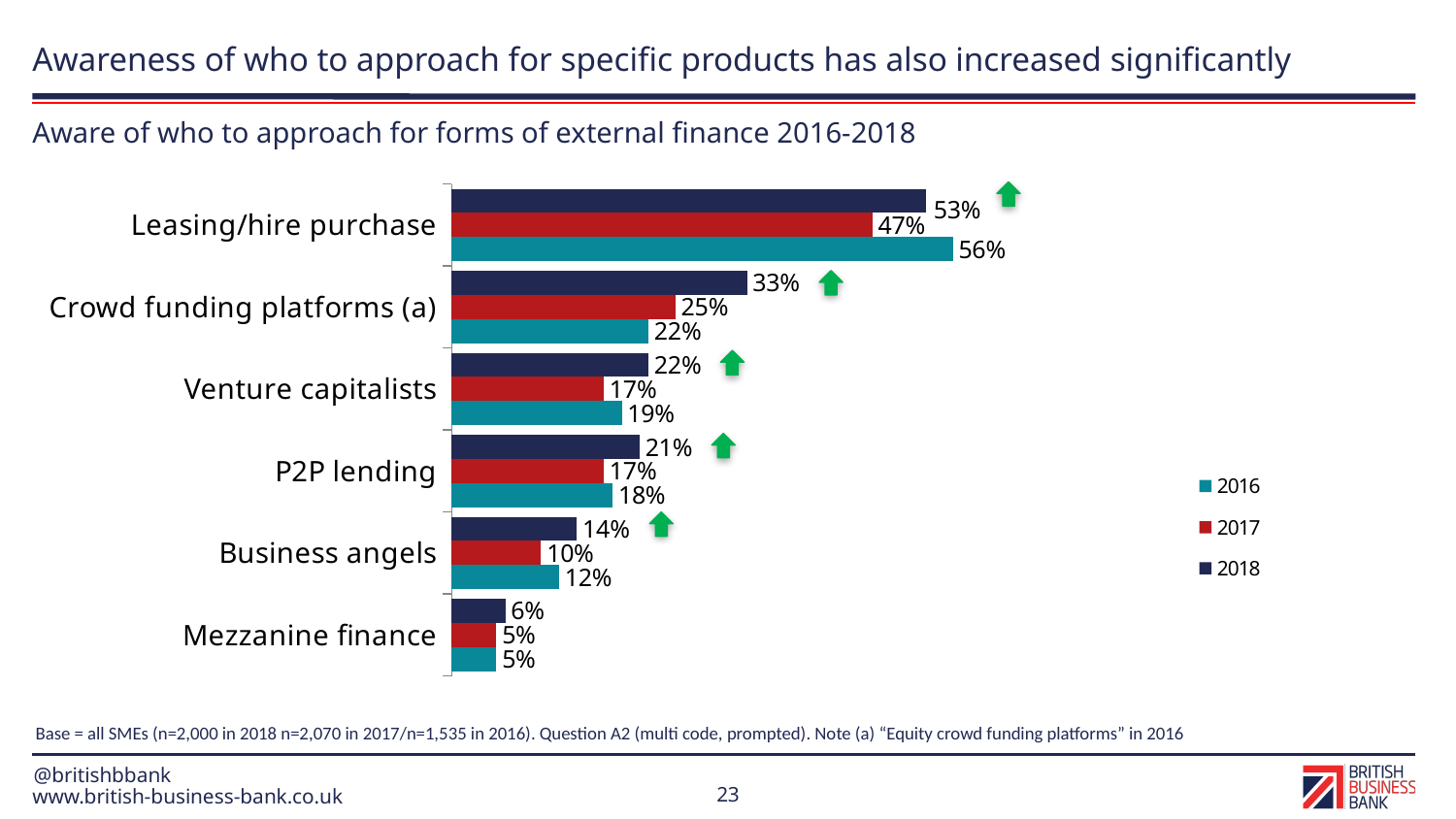
What is the difference between the 2016 and 2018 values for Leasing/hire purchase? 3% What is the 2018 value for Leasing/hire purchase? 53% What type of chart is shown on the slide? Bar chart What is the 2017 value for Business angels? 10% How many categories are shown on the chart? 6 What is the 2016 value for Crowd funding platforms (a)? 22% Which is larger for Venture capitalists: the 2016 value or the 2017 value? 2016 What is the difference between the 2018 and 2017 values for Crowd funding platforms (a)? 8% How many series does the legend list? 3 Which category has the highest 2018 value? Leasing/hire purchase Which category has the lowest 2016 value? Mezzanine finance What is the title of the chart? Aware of who to approach for forms of external finance 2016-2018